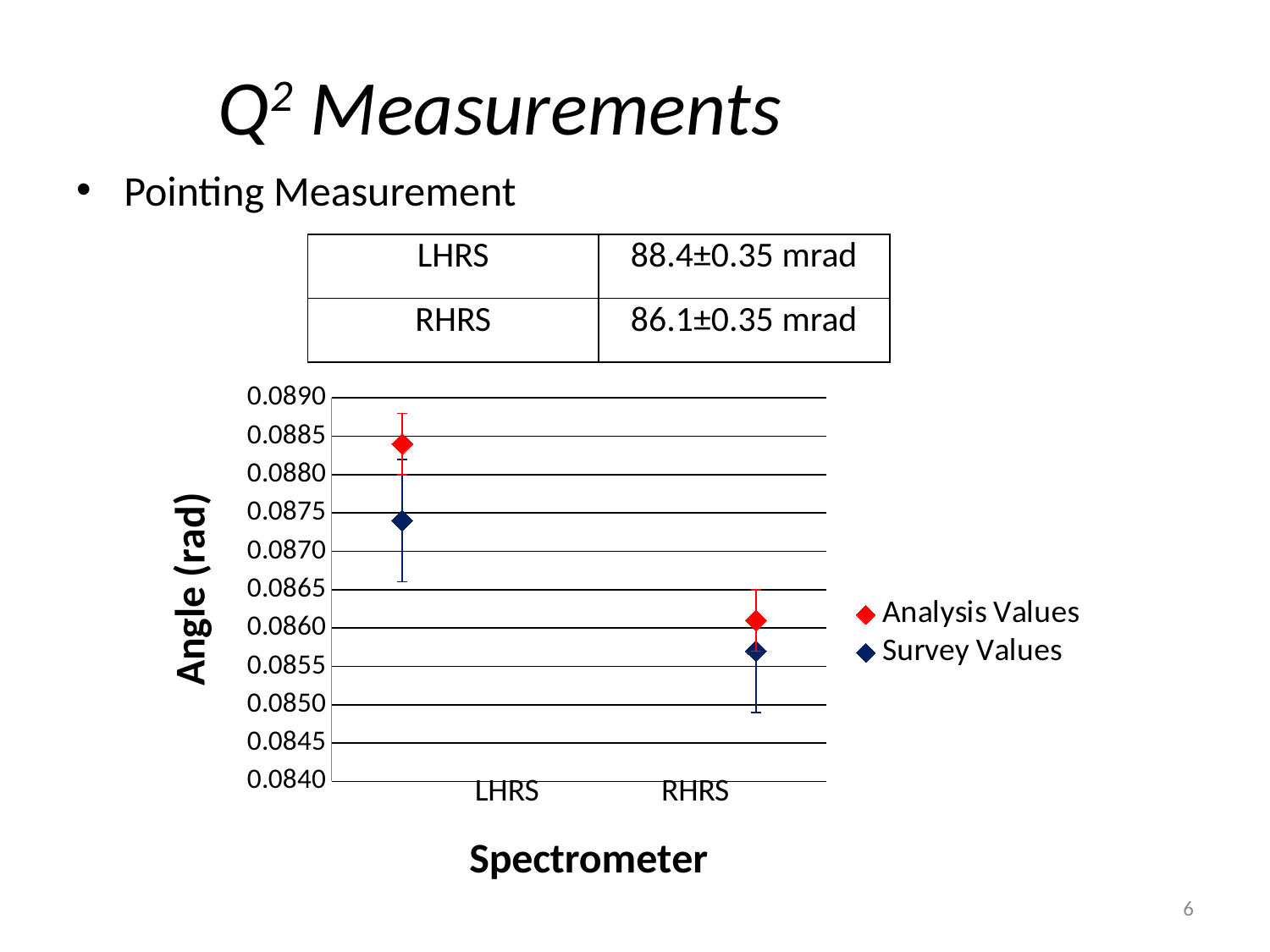
For the Analysis Values series, which spectrometer has the higher angle, LHRS or RHRS? LHRS Is the Survey Values point for LHRS greater or less than 0.0870? greater Do the Analysis Values rise or fall from LHRS to RHRS? fall Is the Analysis Values point for LHRS greater or less than 0.0880? greater Which series has the higher value for LHRS, Analysis Values or Survey Values? Analysis Values How many spectrometer categories are plotted on the x axis of the chart? 2 Is the Analysis Values point for RHRS greater or less than 0.0865? less What kind of chart is shown on the slide? scatter chart How many series does the chart's legend list? 2 What is the title of the chart's y axis? Angle (rad) Which series has the higher value for RHRS, Analysis Values or Survey Values? Analysis Values